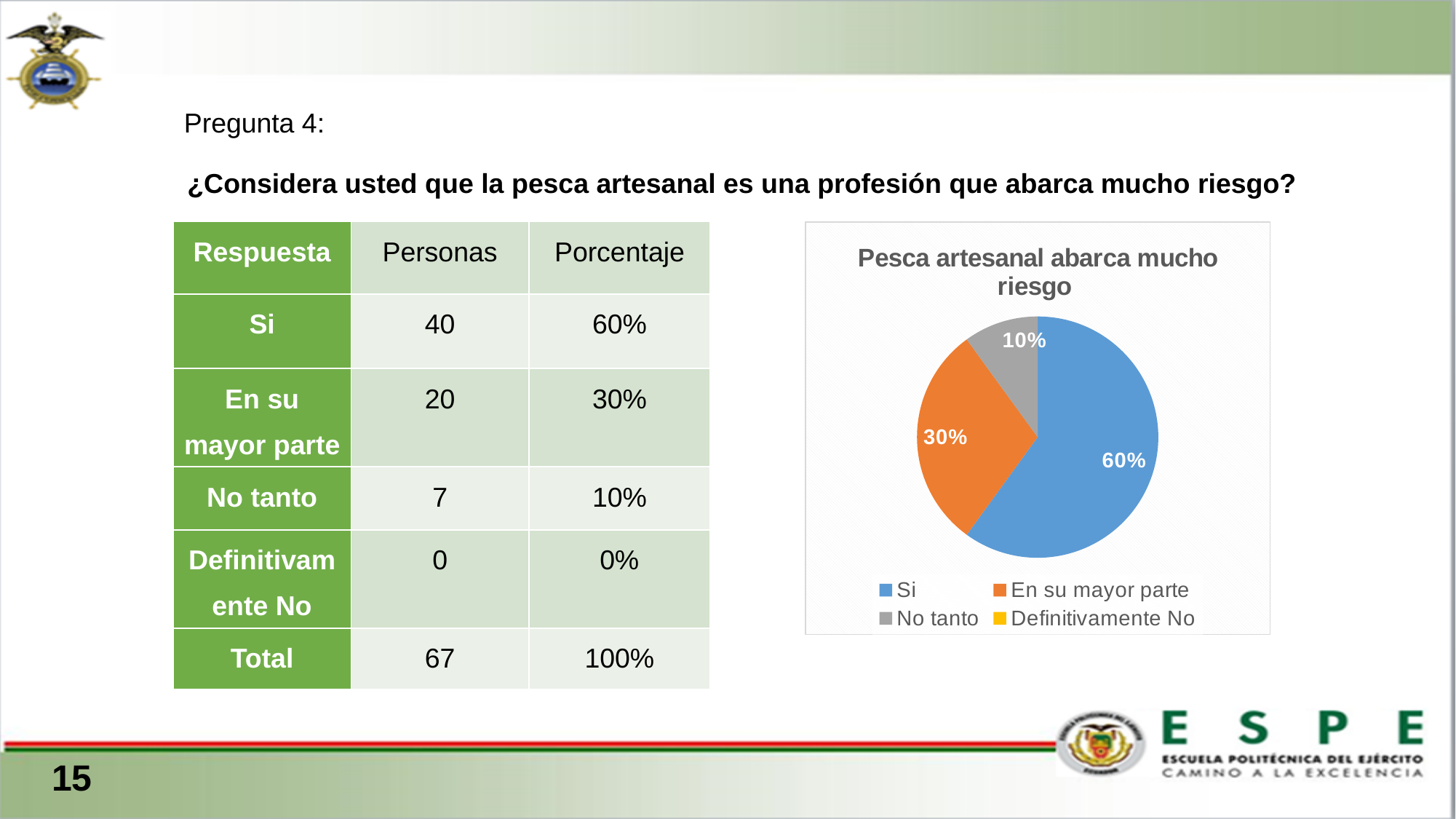
What percentage does the 'Si' slice show in the pie chart? 60% Which slice is larger, 'En su mayor parte' or 'No tanto'? En su mayor parte What is the combined share of the 'En su mayor parte' and 'No tanto' slices? 40% What kind of chart is shown on the slide? pie chart What is the difference in percentage points between the 'Si' slice and the 'En su mayor parte' slice? 30% What percentage does the 'En su mayor parte' slice show in the pie chart? 30% What is the title of the pie chart? Pesca artesanal abarca mucho riesgo How many entries does the pie chart legend list? 4 Which labelled slice is the smallest in the pie chart? No tanto What percentage does the 'No tanto' slice show in the pie chart? 10% Which category has the largest slice in the pie chart? Si What colour is the 'Si' slice in the pie chart? blue